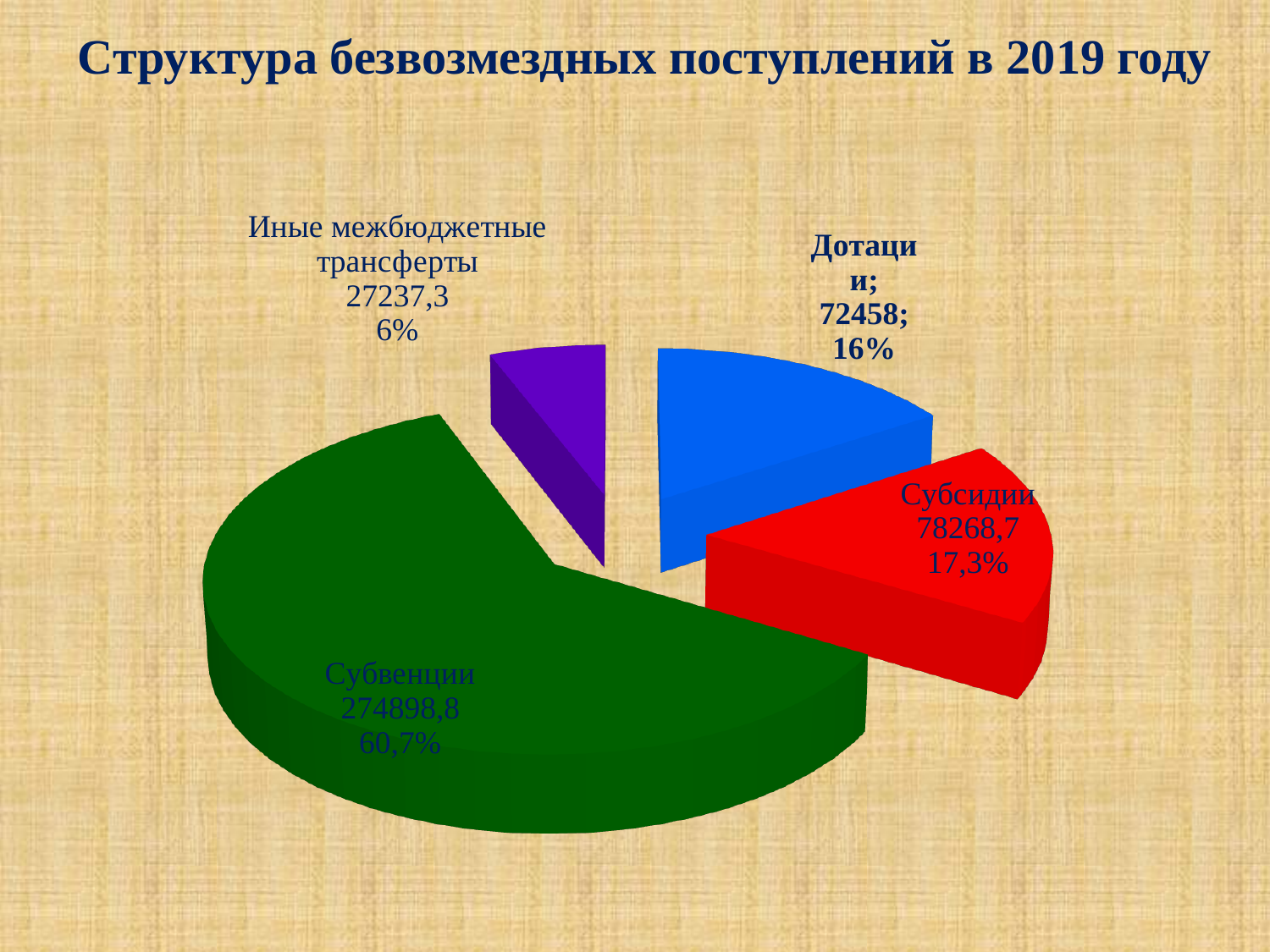
What is the value shown for Дотации? 72458 What is the value shown for Иные межбюджетные трансферты? 27237,3 What is the value shown for Субсидии? 78268,7 What share of the pie does Субсидии represent? 17,3% What is the title of the chart? Структура безвозмездных поступлений в 2019 году Which category has the largest slice? Субвенции Which category has the smallest slice? Иные межбюджетные трансферты What kind of chart is shown on the slide? Pie chart What share of the pie does Субвенции represent? 60,7% Which colour is the Субвенции slice? Green What is the value shown for Субвенции? 274898,8 How many slices does the pie chart have? 4